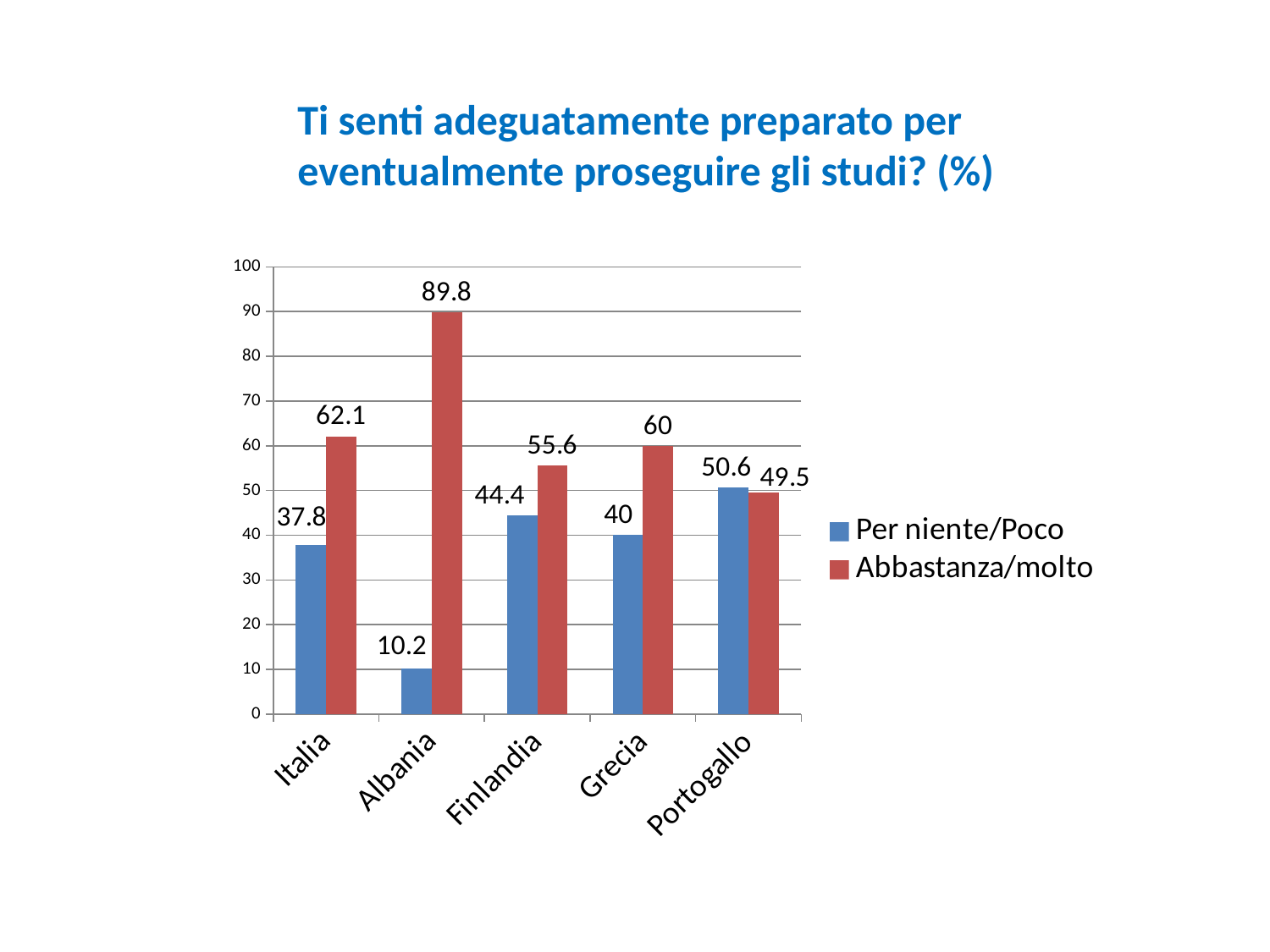
Which colour represents the Abbastanza/molto series? red Is the Abbastanza/molto value for Italia greater or less than 60? greater What is the value for Albania in the Abbastanza/molto series? 89.8 Which is larger for Portogallo: Per niente/Poco or Abbastanza/molto? Per niente/Poco What is the value for Italia in the Per niente/Poco series? 37.8 How many countries are shown on the x axis? 5 What is the value for Grecia in the Abbastanza/molto series? 60 How many series does the legend list? 2 Which country has the highest value in the Abbastanza/molto series? Albania Which country has the lowest value in the Per niente/Poco series? Albania What is the difference between the Abbastanza/molto and Per niente/Poco values for Finlandia? 11.2 What kind of chart is shown on the slide? bar chart